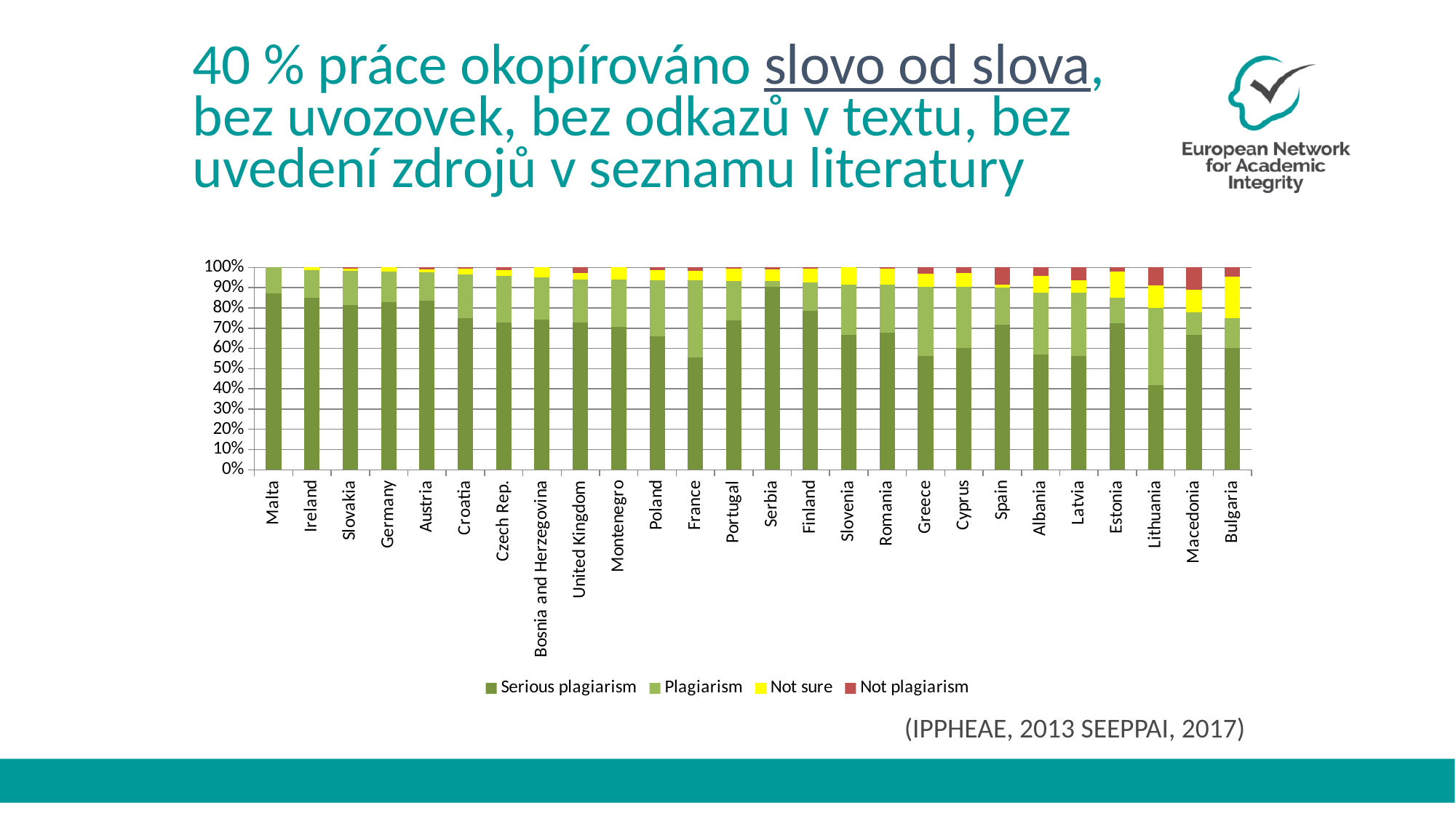
Is the 'Serious plagiarism' value for Malta greater or less than 80%? greater Is the 'Serious plagiarism' value for Lithuania greater or less than 50%? less Is the 'Serious plagiarism' value for France greater or less than 50%? greater Which has a larger 'Serious plagiarism' share, Malta or Lithuania? Malta How many series does the chart's legend list? 4 How many countries are shown on the x axis of the chart? 26 What kind of chart is shown on the slide? stacked bar chart Which has a larger 'Serious plagiarism' share, Finland or Bulgaria? Finland Which series is shown in yellow in the chart? Not sure Which country has the lowest share of 'Serious plagiarism'? Lithuania Which series is shown in red in the chart? Not plagiarism